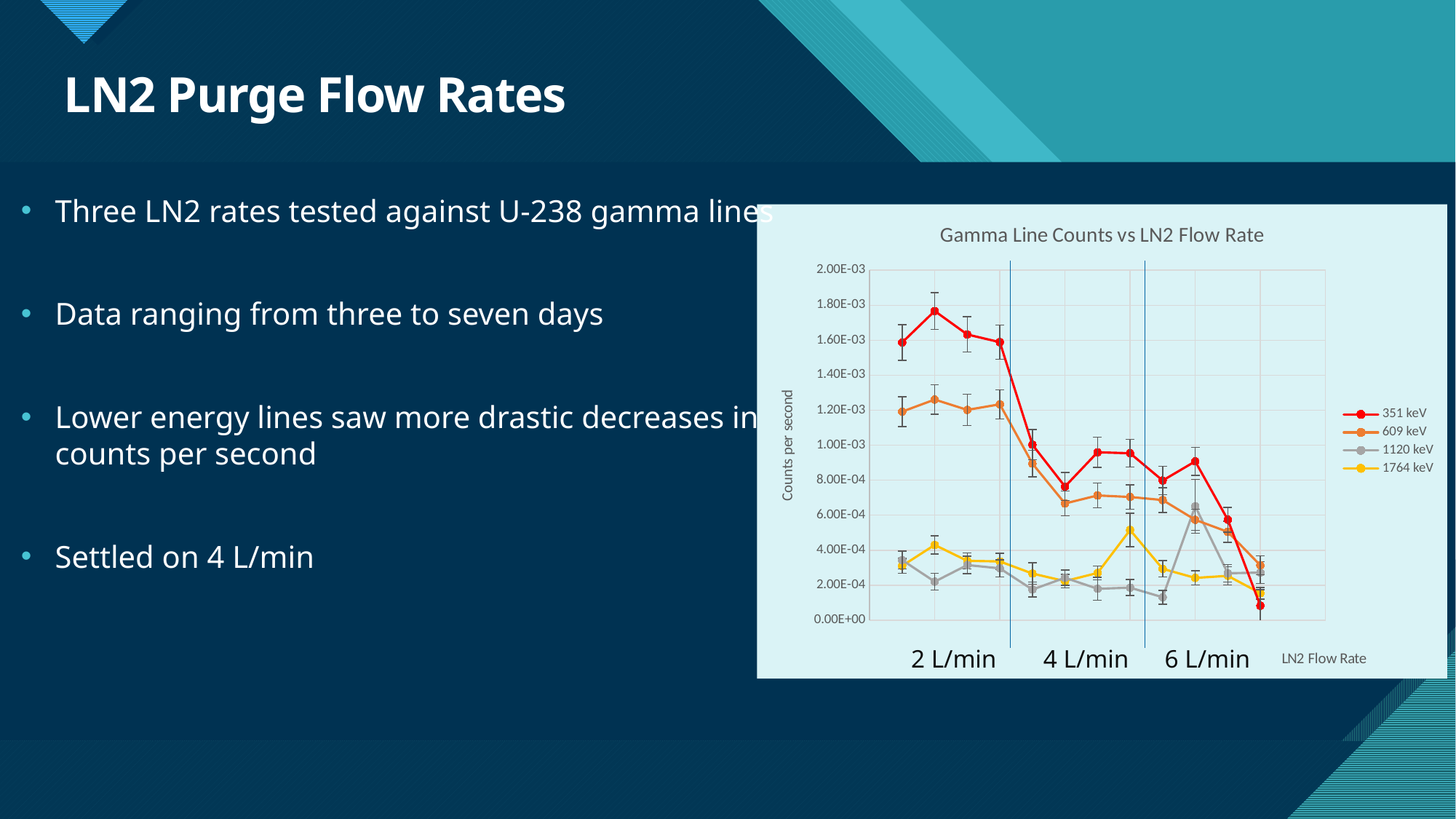
What kind of chart is shown on the slide? line chart Are all plotted values of the 1764 keV series greater or less than 8.00E-04? less How many series does the legend of the chart list? 4 Is the first plotted value of the 351 keV series greater or less than 1.40E-03? greater Does the 351 keV series generally rise or fall from left to right across the x axis? fall Is the first plotted value of the 609 keV series greater or less than 1.00E-03? greater In the 2 L/min region, which series is higher: 351 keV or 1120 keV? 351 keV In the 2 L/min region, which series is higher: 609 keV or 1764 keV? 609 keV What is the title of the chart? Gamma Line Counts vs LN2 Flow Rate Which series has the highest counts per second across the chart? 351 keV How many LN2 flow rate groups are labelled on the x axis? 3 Which series are listed in the chart's legend? 351 keV, 609 keV, 1120 keV, 1764 keV